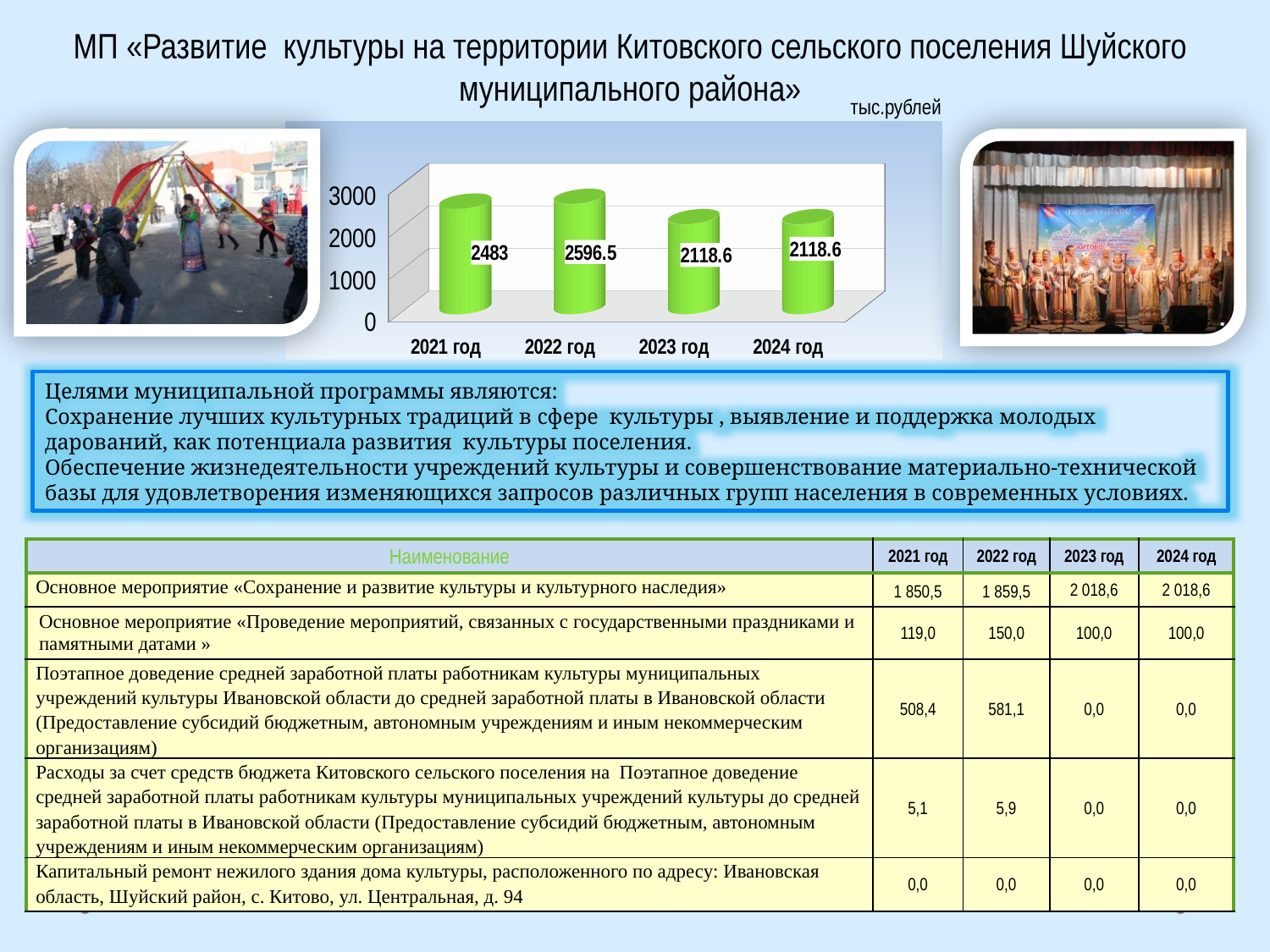
Which year has the highest value on the chart? 2022 год What unit is indicated above the chart? тыс.рублей What is the difference between the values for 2022 год and 2021 год? 113.5 What kind of chart is shown on the slide? bar chart What is the value for 2021 год on the chart? 2483 What is the value for 2022 год on the chart? 2596.5 What is the value for 2023 год on the chart? 2118.6 What is the difference between the values for 2022 год and 2023 год? 477.9 What is the value for 2024 год on the chart? 2118.6 Which is larger, the value for 2021 год or the value for 2023 год? 2021 год Is the value for 2022 год greater or less than 2000? greater How many years are shown on the chart? 4